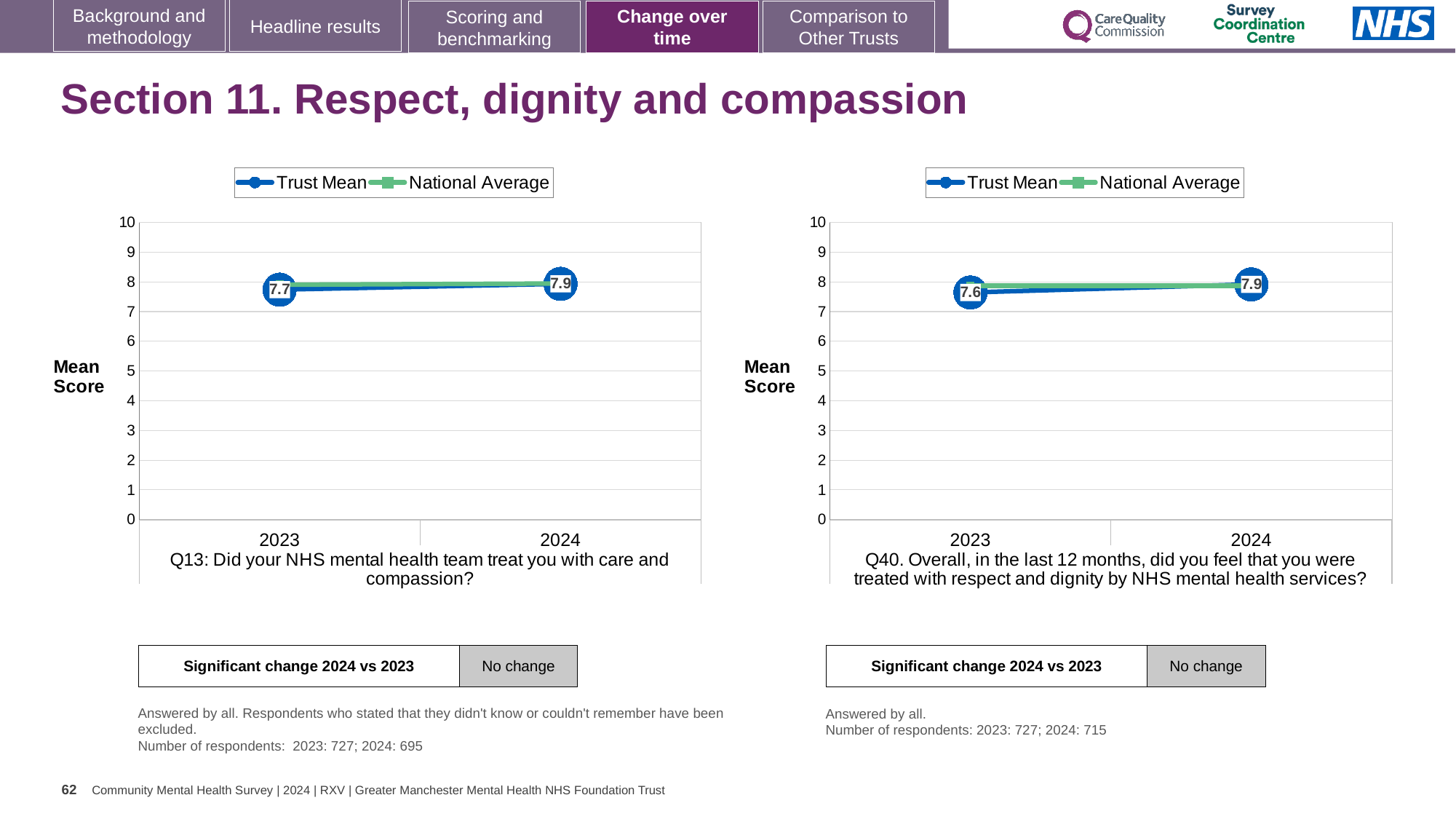
In the left chart (Q13), what is the Trust Mean score for 2024? 7.9 In the left chart (Q13), by how much did the Trust Mean change from 2023 to 2024? 0.2 In the right chart (Q40), which year has the higher Trust Mean, 2023 or 2024? 2024 In the right chart (Q40), what is the Trust Mean score for 2024? 7.9 In the right chart (Q40), by how much did the Trust Mean change from 2023 to 2024? 0.3 In the left chart (Q13), does the Trust Mean rise or fall from 2023 to 2024? rise How many series does the legend of the right chart (Q40) list? 2 What kind of chart is the left chart (Q13)? line chart In the left chart (Q13), what is the Trust Mean score for 2023? 7.7 In the right chart (Q40), is the National Average value for 2024 greater or less than 5? greater In the right chart (Q40), what is the Trust Mean score for 2023? 7.6 How many years are plotted on the x axis of the left chart (Q13)? 2